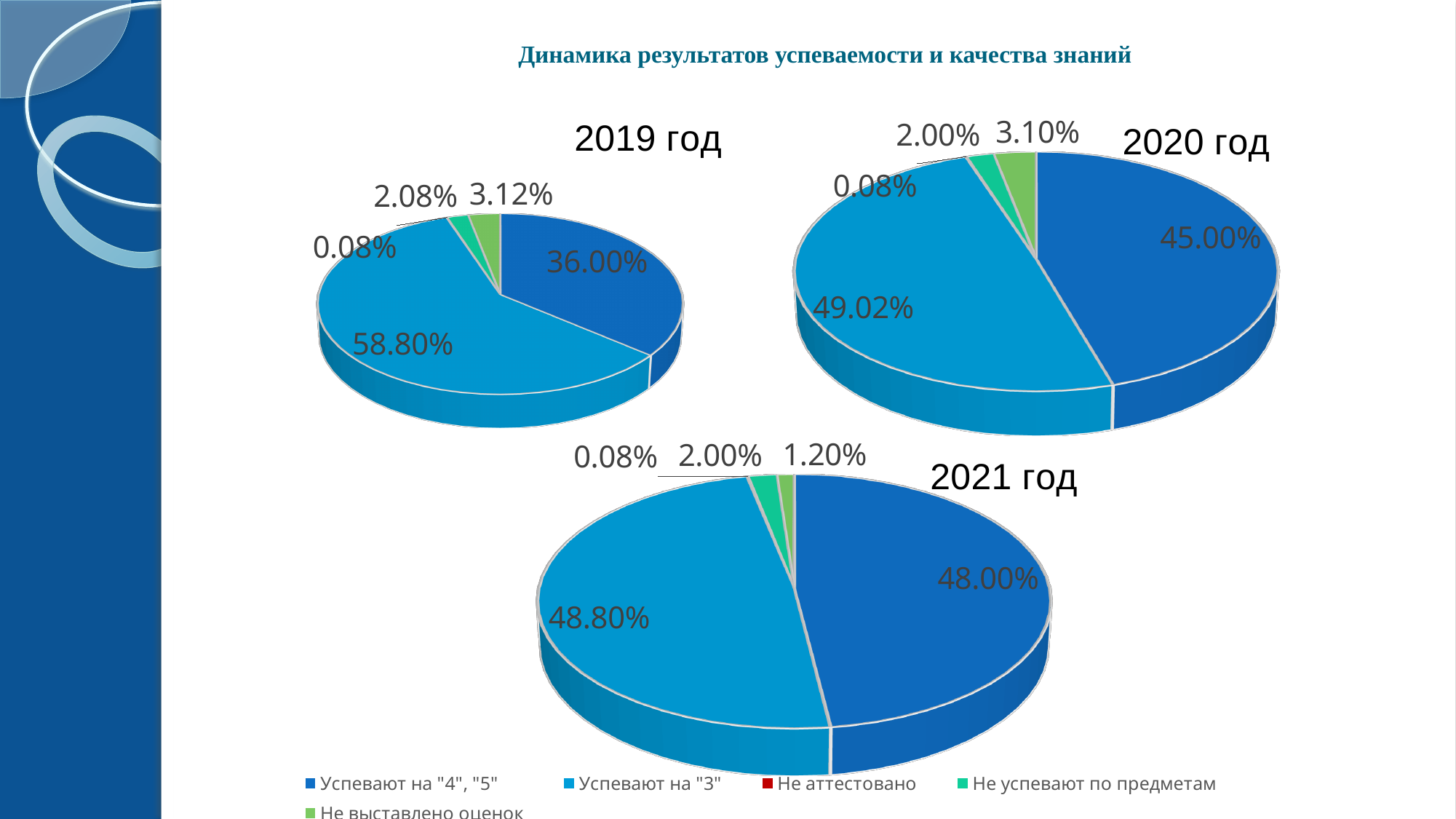
In the 2019 год chart, what is the value for Успевают на "3"? 58.80% In the 2020 год chart, what is the value for Успевают на "4", "5"? 45.00% In the 2019 год chart, which is larger: Не успевают по предметам or Не выставлено оценок? Не выставлено оценок In the 2020 год chart, which category has the largest share? Успевают на "3" In the 2021 год chart, what is the difference between Успевают на "3" and Успевают на "4", "5"? 0.80% In the 2019 год chart, which category has the smallest share? Не аттестовано What kind of chart is used for the 2019 год chart? pie chart How many pie charts are shown on the slide? 3 How many entries does the legend list? 5 What is the title of the slide above the charts? Динамика результатов успеваемости и качества знаний In the 2021 год chart, what is the value for Не выставлено оценок? 1.20% In the 2019 год chart, what is the value for Успевают на "4", "5"? 36.00%